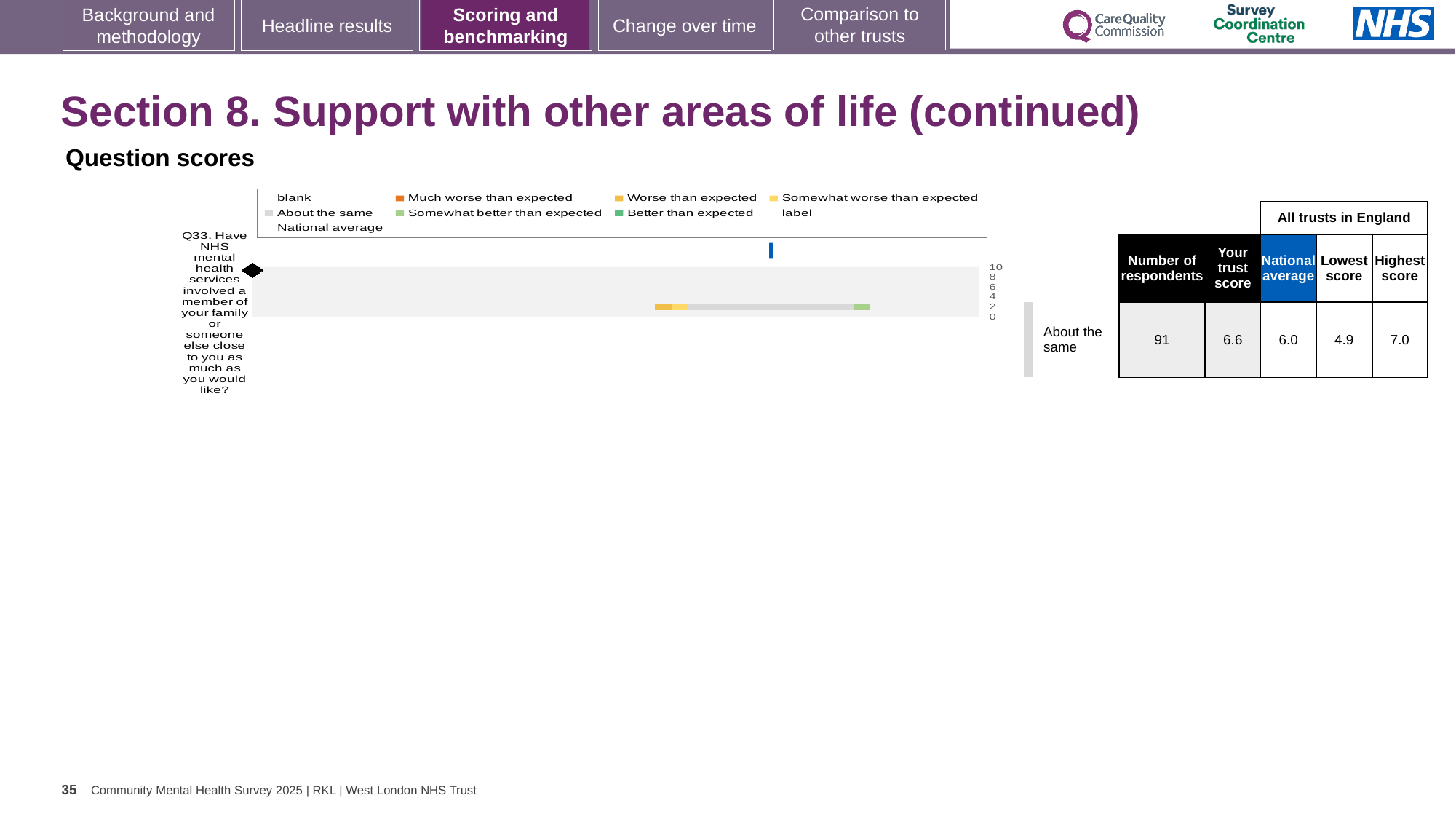
How is the trust's result for Q33 categorised relative to expectations? About the same What kind of chart is shown under 'Question scores'? bar chart What is the trust score for Q33? 6.6 What is the lowest score among all trusts in England for Q33? 4.9 What is the difference between the trust score and the national average for Q33? 0.6 How many questions are plotted in the 'Question scores' chart? 1 Which question is plotted in the 'Question scores' chart? Q33. Have NHS mental health services involved a member of your family or someone else close to you as much as you would like? What is the highest score among all trusts in England for Q33? 7.0 What is the national average score for Q33? 6.0 Which is larger for Q33, the trust score or the national average? the trust score How many respondents answered Q33? 91 What is the difference between the highest and lowest scores among all trusts in England for Q33? 2.1